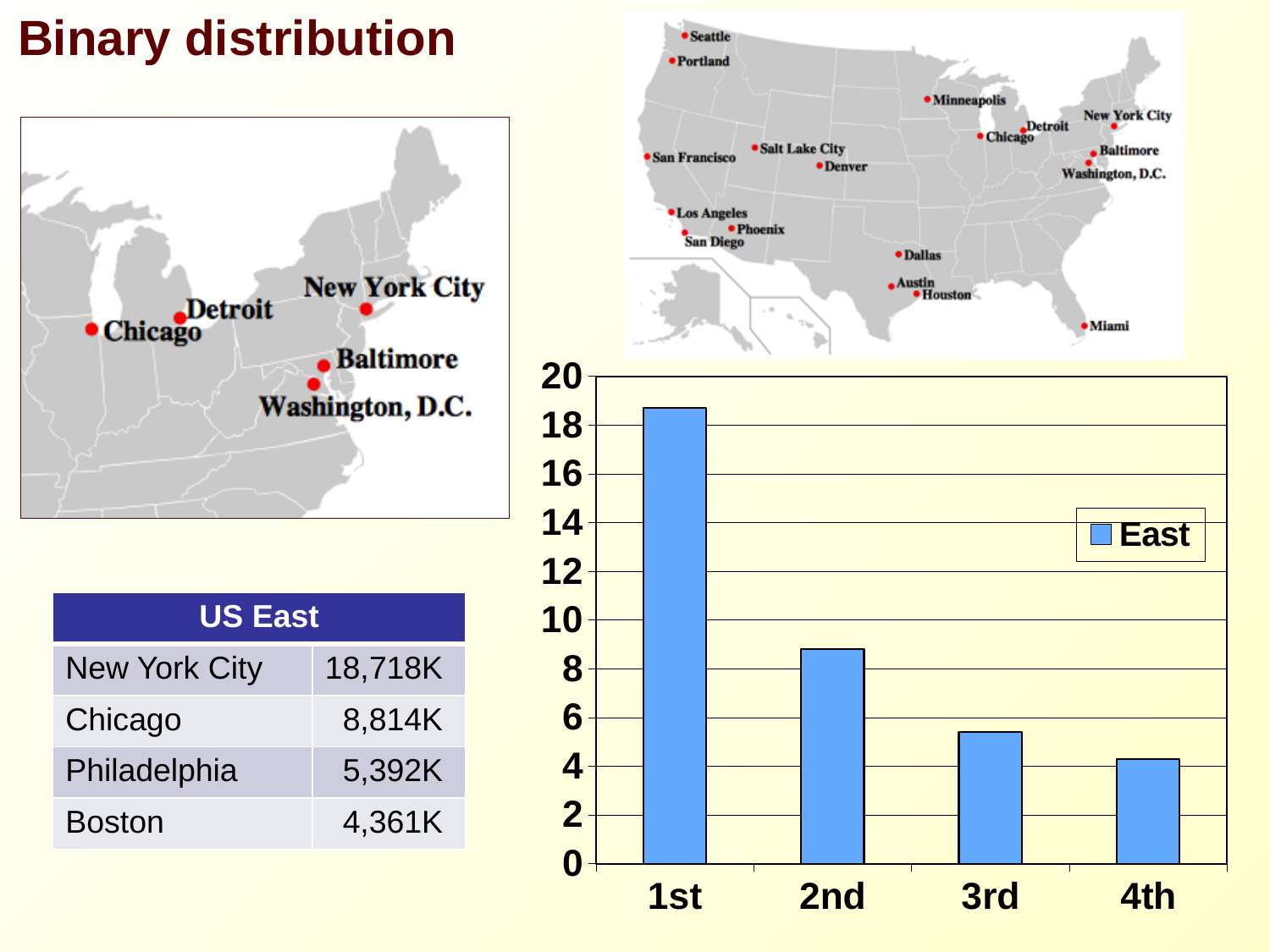
Is the value for 1st greater or less than 18? greater What is the name of the series shown in the chart legend? East Which category has the highest bar in the chart? 1st Do the bar values rise or fall from 1st to 4th? fall Which category has the lowest bar in the chart? 4th Which bar is taller, 2nd or 3rd? 2nd What kind of chart is shown on the slide? bar chart Is the value for 2nd greater or less than 10? less Is the value for 4th greater or less than 2? greater How many categories are shown on the x axis of the bar chart? 4 How many series does the legend of the bar chart list? 1